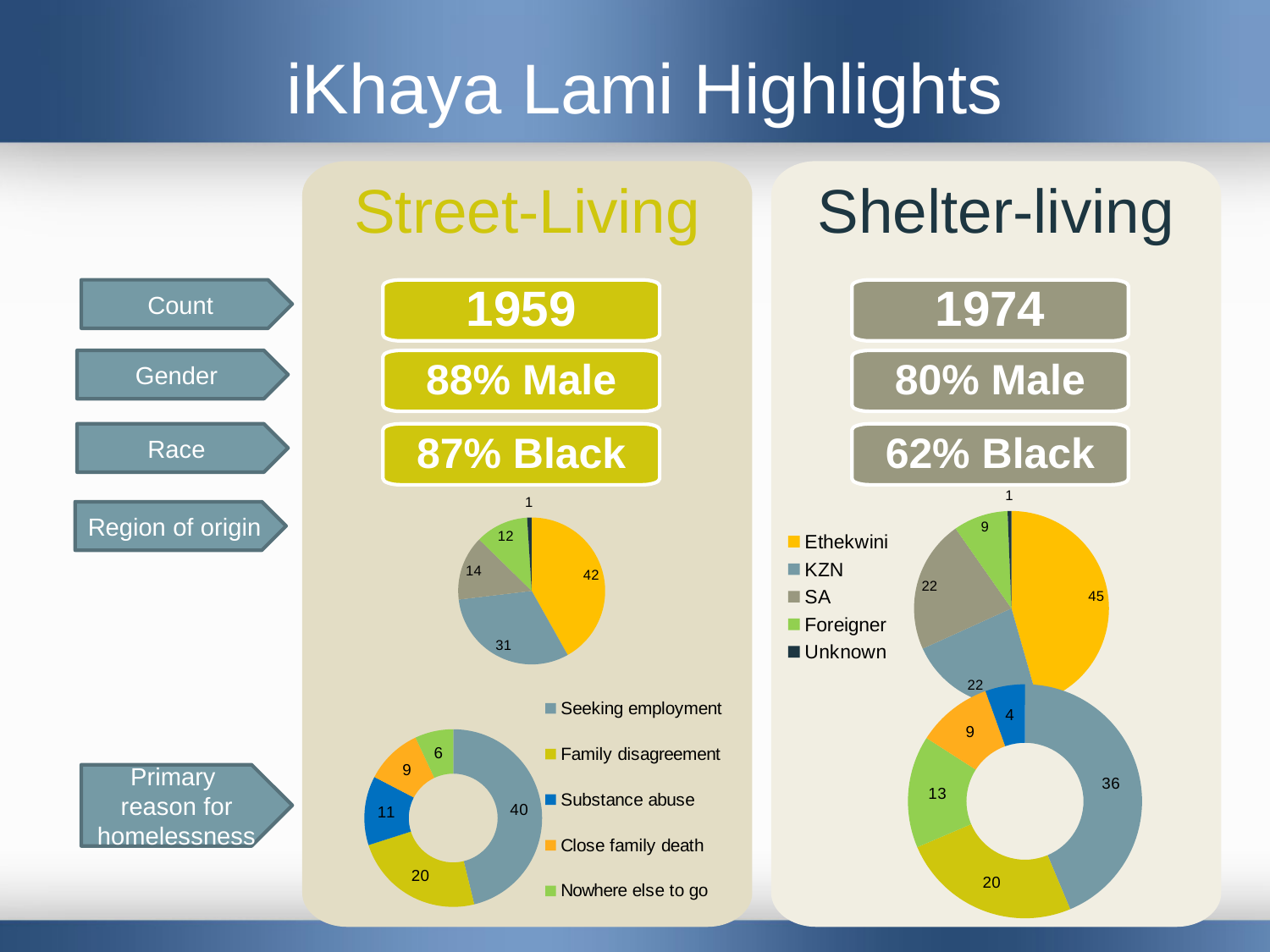
In the Shelter-living region of origin pie chart, which category has the highest value? Ethekwini In the Shelter-living primary reason for homelessness doughnut chart, what is the value for Nowhere else to go? 13 In the Shelter-living primary reason for homelessness doughnut chart, what is the total of all the labelled values? 82 What kind of chart is used for the Street-Living region of origin data? Pie chart How many categories does the region of origin legend list? 5 In the Shelter-living primary reason for homelessness doughnut chart, which is larger: Close family death or Substance abuse? Close family death In the Street-Living primary reason for homelessness doughnut chart, which category has the lowest value? Nowhere else to go In the Street-Living region of origin pie chart, what is the value for Ethekwini? 42 In the region of origin legend, which colour represents Foreigner? Green In the Shelter-living region of origin pie chart, what is the value for KZN? 22 In the Street-Living region of origin pie chart, what is the difference between the values for Ethekwini and KZN? 11 In the Street-Living primary reason for homelessness doughnut chart, what is the value for Substance abuse? 11